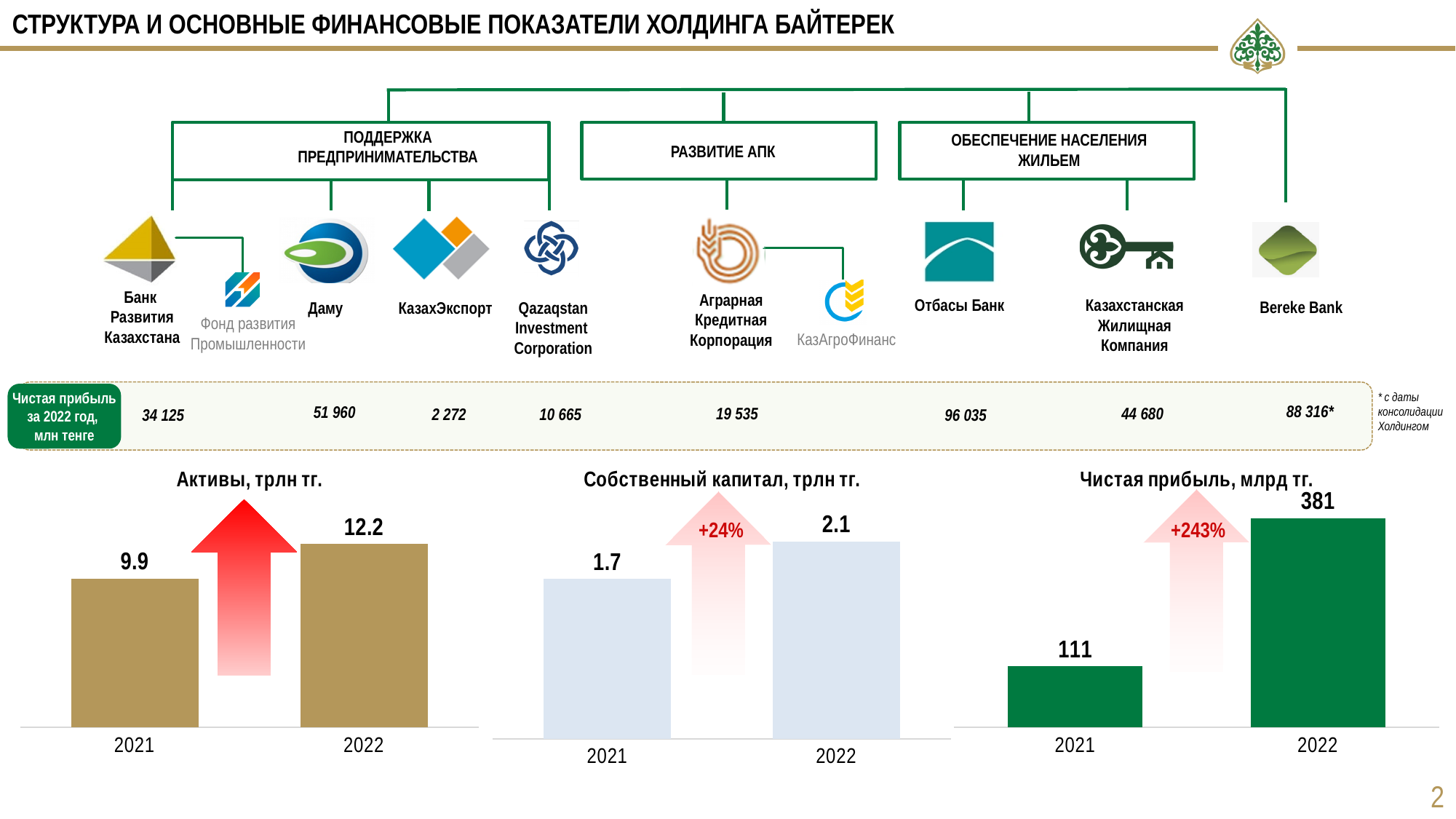
In the chart titled "Активы, трлн тг.", what is the value for 2022? 12.2 In the chart titled "Чистая прибыль, млрд тг.", what is the value for 2021? 111 In the chart titled "Собственный капитал, трлн тг.", what is the value for 2022? 2.1 In the chart titled "Чистая прибыль, млрд тг.", what is the value for 2022? 381 In the chart titled "Чистая прибыль, млрд тг.", what is the difference between the 2022 and 2021 values? 270 In the chart titled "Чистая прибыль, млрд тг.", do the values rise or fall from 2021 to 2022? rise In the chart titled "Собственный капитал, трлн тг.", what is the value for 2021? 1.7 In the chart titled "Собственный капитал, трлн тг.", which year has the higher value? 2022 In the chart titled "Активы, трлн тг.", what is the value for 2021? 9.9 How many categories are shown on the x axis of the chart titled "Активы, трлн тг."? 2 In the chart titled "Активы, трлн тг.", what is the difference between the 2022 and 2021 values? 2.3 What kind of chart is the chart titled "Чистая прибыль, млрд тг."? bar chart